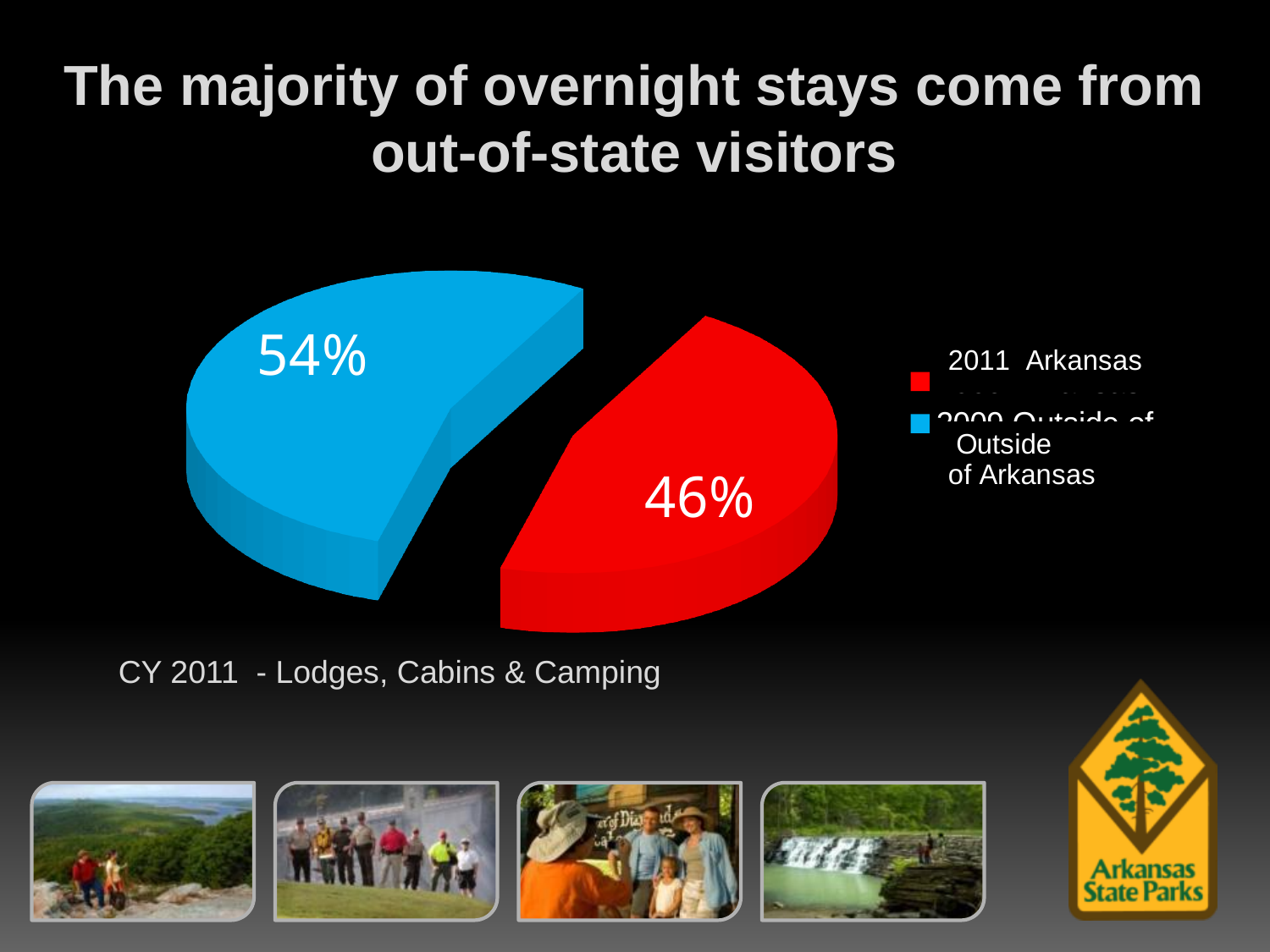
What is the title of the slide containing the pie chart? The majority of overnight stays come from out-of-state visitors Which slice of the pie is the smallest? Arkansas (46%) By how many percentage points does the Outside of Arkansas share exceed the Arkansas share? 8 percentage points What share of the pie does the red slice (Arkansas) represent? 46% What kind of chart is shown on the slide? Pie chart Is the Outside of Arkansas slice larger or smaller than the Arkansas slice? Larger Which slice of the pie is the largest? Outside of Arkansas (54%) Is the share for Arkansas greater or less than 50%? less How many slices does the pie chart have? 2 Which colour represents Arkansas in the pie chart? Red What share of the pie does the blue slice (Outside of Arkansas) represent? 54%